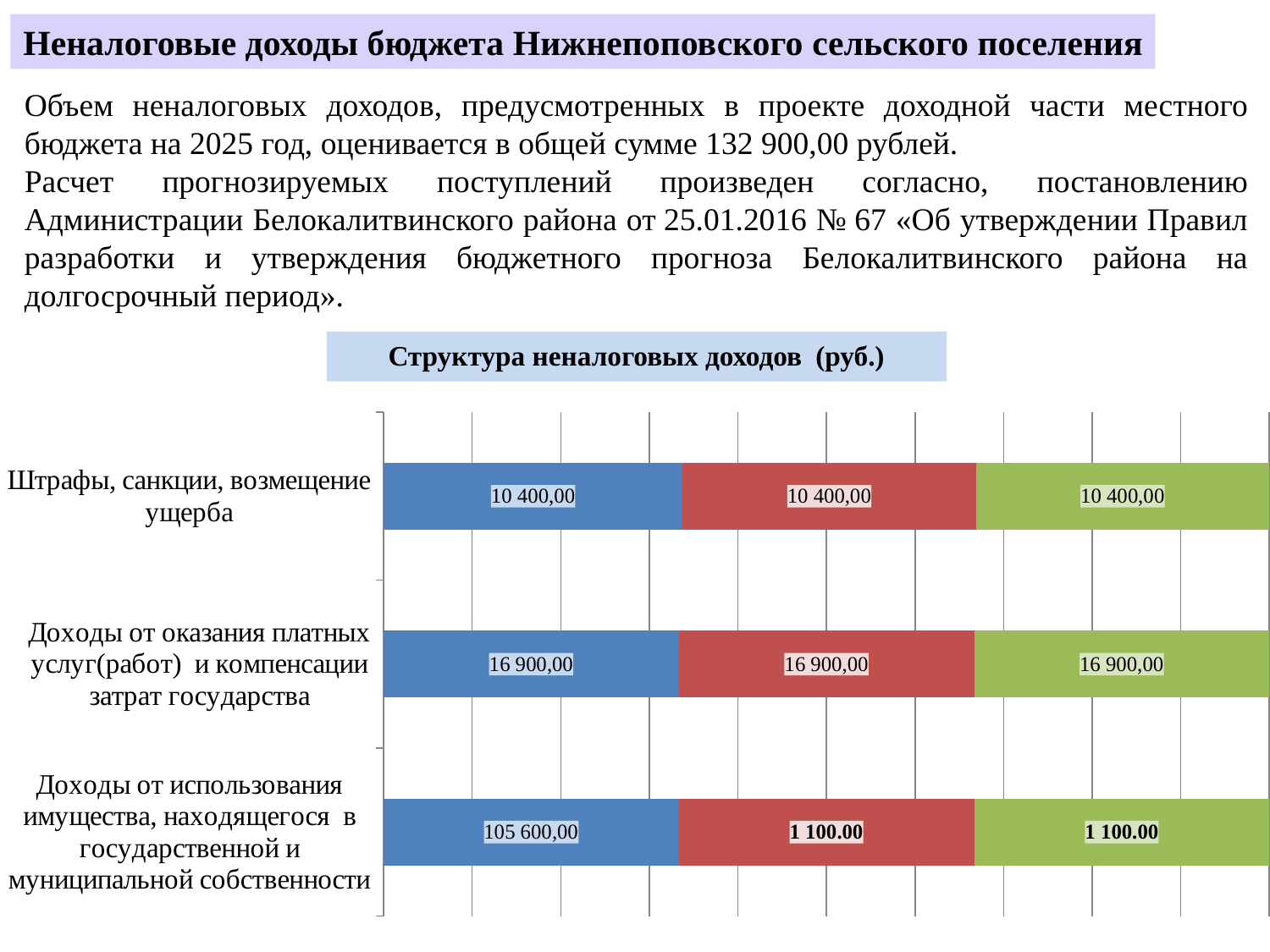
How many categories are shown on the chart "Структура неналоговых доходов (руб.)"? 3 What is the total of the three labelled segments in the bar for "Штрафы, санкции, возмещение ущерба"? 31 200,00 What is the difference between the blue segment values for "Доходы от использования имущества" and "Доходы от оказания платных услуг(работ)"? 88 700,00 Which category has the highest value in the blue segment? Доходы от использования имущества, находящегося в государственной и муниципальной собственности What is the value of the blue segment for "Доходы от использования имущества, находящегося в государственной и муниципальной собственности"? 105 600,00 Which is larger in the blue segment: "Доходы от оказания платных услуг(работ)" or "Штрафы, санкции, возмещение ущерба"? Доходы от оказания платных услуг(работ) и компенсации затрат государства Which category has the lowest value in the blue segment? Штрафы, санкции, возмещение ущерба What kind of chart is shown under the title "Структура неналоговых доходов (руб.)"? Stacked bar chart What is the value of the blue segment for "Доходы от оказания платных услуг(работ) и компенсации затрат государства"? 16 900,00 What is the value of the blue segment for "Штрафы, санкции, возмещение ущерба"? 10 400,00 What is the value of the red segment for "Доходы от использования имущества, находящегося в государственной и муниципальной собственности"? 1 100.00 What is the title of the chart on the slide? Структура неналоговых доходов (руб.)